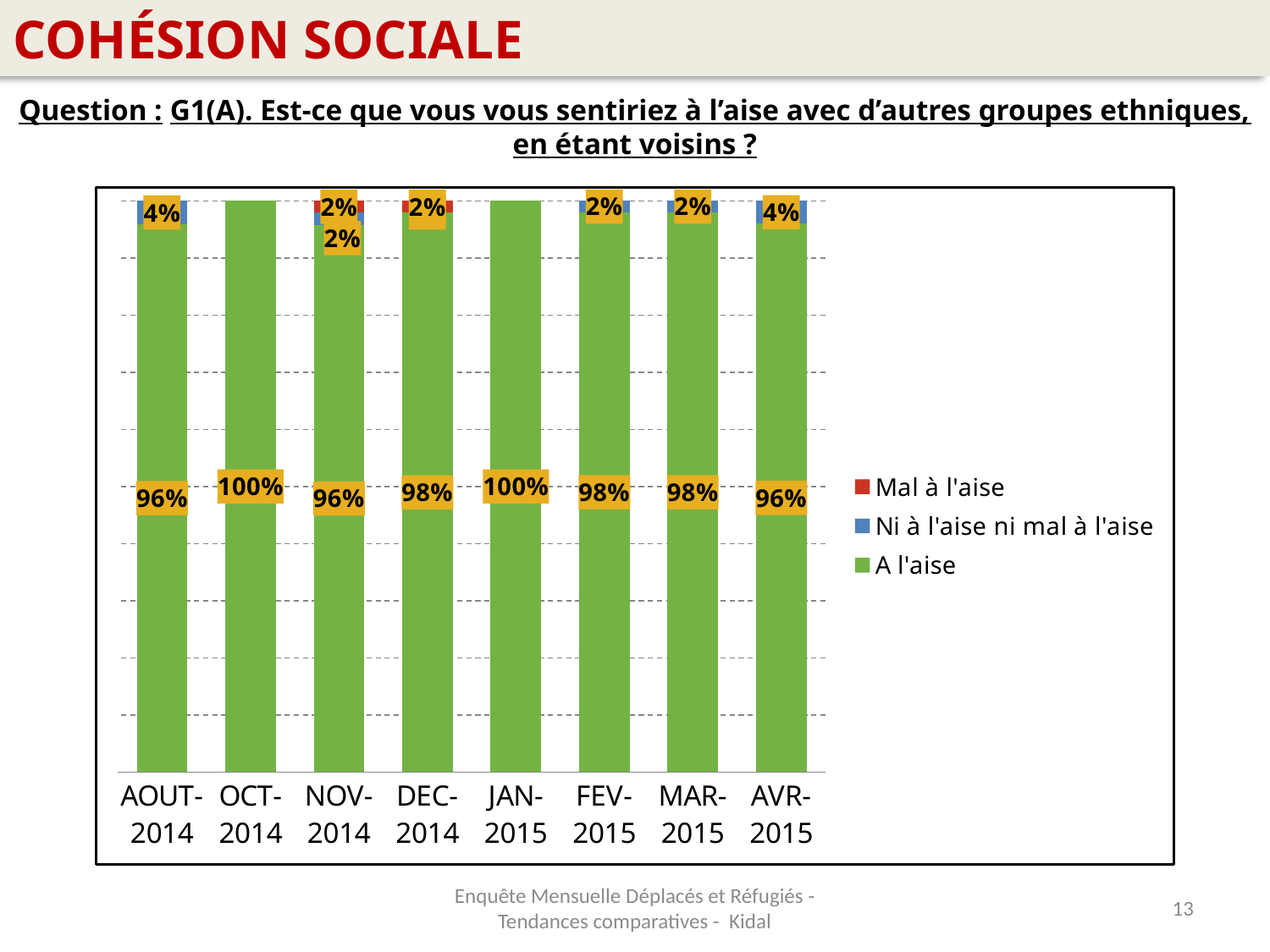
What is the value for "A l'aise" in AOUT-2014? 96% What kind of chart is shown on the slide? stacked bar chart How many months are shown on the x axis? 8 What is the difference between the "A l'aise" values for OCT-2014 and NOV-2014? 4% How many series does the legend list? 3 What is the value for "A l'aise" in JAN-2015? 100% Which is larger, the "A l'aise" value for FEV-2015 or for AVR-2015? FEV-2015 What is the value for "A l'aise" in AVR-2015? 96% What is the value for "A l'aise" in DEC-2014? 98% In which months does "A l'aise" reach 100%? OCT-2014 and JAN-2015 What is the value for "Ni à l'aise ni mal à l'aise" in AOUT-2014? 4% Which legend entry is shown in green? A l'aise